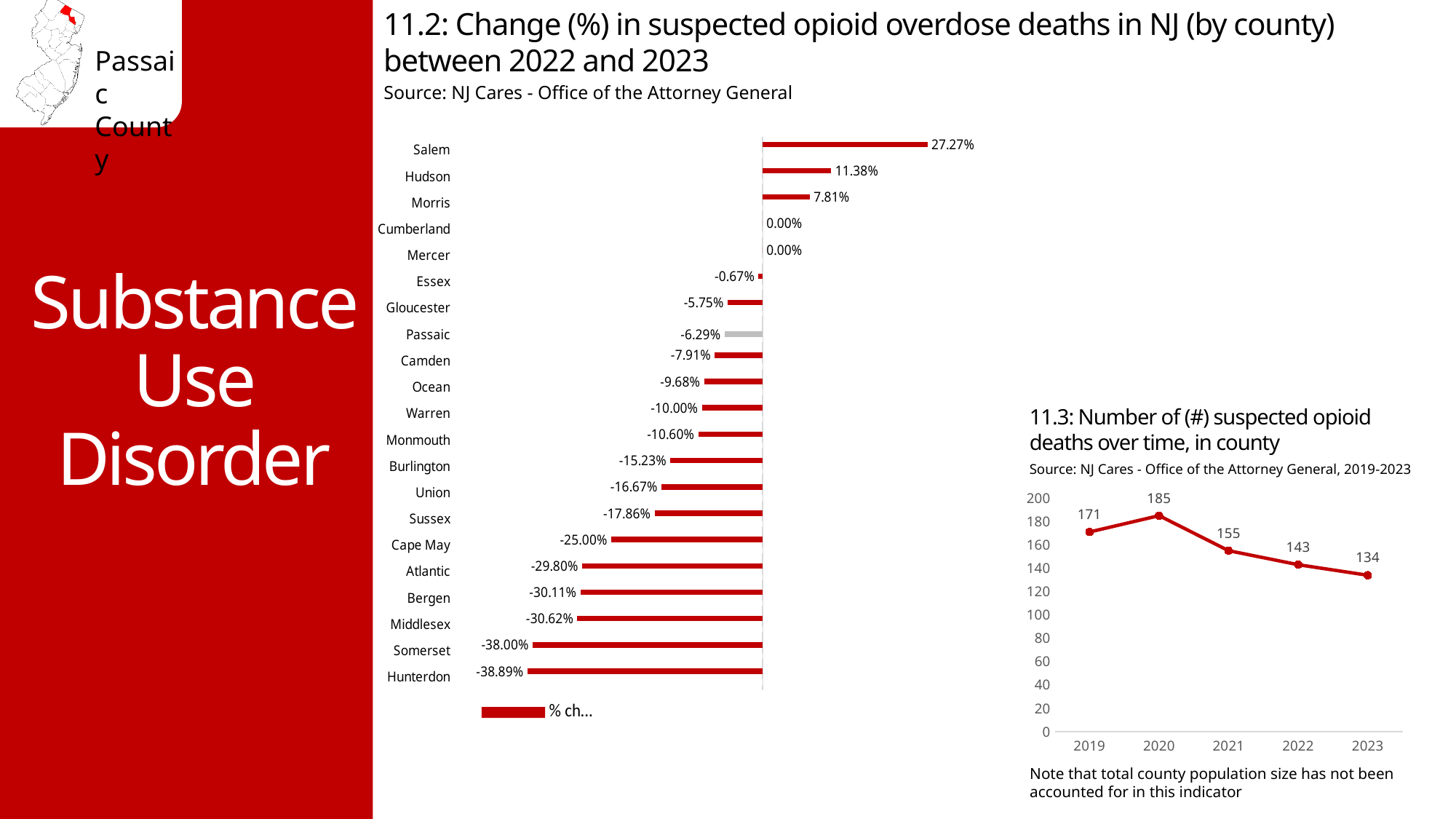
In chart 11.3, do the values rise or fall from 2020 to 2023? Fall In chart 11.2, which county has the lowest percentage change? Hunterdon In chart 11.2, what is the value for Hudson? 11.38% In chart 11.3, what is the difference between the 2020 and 2023 values? 51 In chart 11.2, which county has the highest percentage change? Salem In chart 11.3 (number of suspected opioid deaths over time), what is the value for 2020? 185 In chart 11.2, how many counties are shown? 21 In chart 11.2 (change in suspected opioid overdose deaths by county), what is the value for Passaic? -6.29% In chart 11.2, which is larger, the value for Bergen or the value for Middlesex? Bergen In chart 11.3, how many data points are plotted? 5 In chart 11.3, which year has the lowest number of suspected opioid deaths? 2023 In chart 11.2, what kind of chart is used? Bar chart